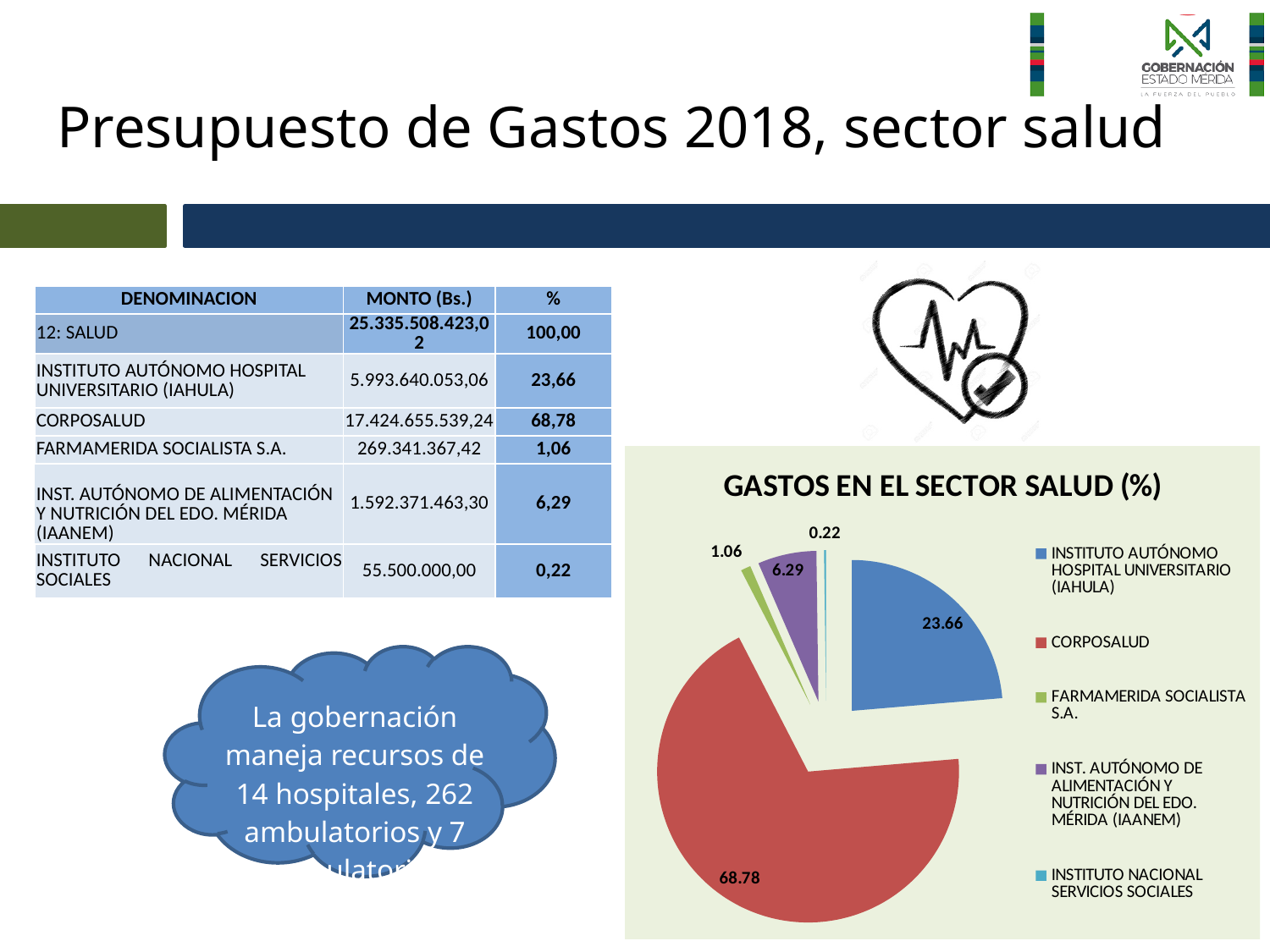
What is the value shown for INST. AUTÓNOMO DE ALIMENTACIÓN Y NUTRICIÓN DEL EDO. MÉRIDA (IAANEM) in the pie chart? 6.29 Which is larger in the pie chart, the value for IAANEM or the value for FARMAMERIDA SOCIALISTA S.A.? IAANEM How many slices does the pie chart have? 5 What is the value shown for INSTITUTO NACIONAL SERVICIOS SOCIALES in the pie chart? 0.22 What is the value shown for INSTITUTO AUTÓNOMO HOSPITAL UNIVERSITARIO (IAHULA) in the pie chart? 23.66 What is the title of the pie chart? GASTOS EN EL SECTOR SALUD (%) What is the value shown for FARMAMERIDA SOCIALISTA S.A. in the pie chart? 1.06 What is the value shown for CORPOSALUD in the pie chart? 68.78 Which category has the largest slice in the pie chart? CORPOSALUD What is the difference between the CORPOSALUD value and the IAHULA value in the pie chart? 45.12 Which category has the smallest slice in the pie chart? INSTITUTO NACIONAL SERVICIOS SOCIALES What type of chart is shown under the title "GASTOS EN EL SECTOR SALUD (%)"? Pie chart